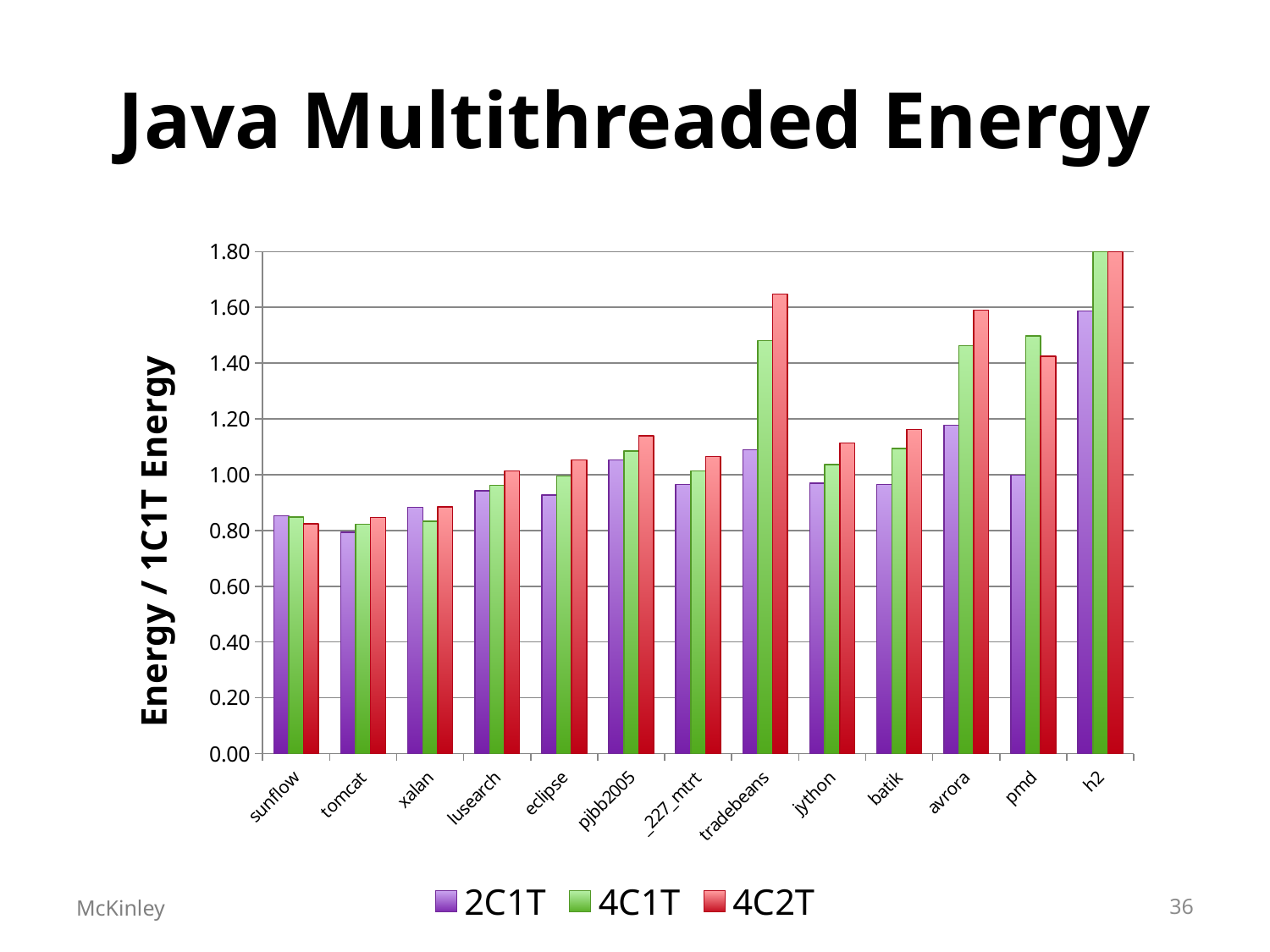
What is the title of the chart? Java Multithreaded Energy For tradebeans, which is larger: the 2C1T value or the 4C2T value? 4C2T Which benchmark has the highest 2C1T value? h2 Is the 2C1T value for sunflow greater or less than 1.00? less Is the 2C1T value for tomcat greater or less than 1.00? less How many series does the legend list? 3 Is the 4C2T value for tradebeans greater or less than 1.40? greater What is the label on the y axis? Energy / 1C1T Energy What kind of chart is shown on the slide? bar chart How many benchmark categories are shown on the x axis? 13 For avrora, which is larger: the 2C1T value or the 4C2T value? 4C2T